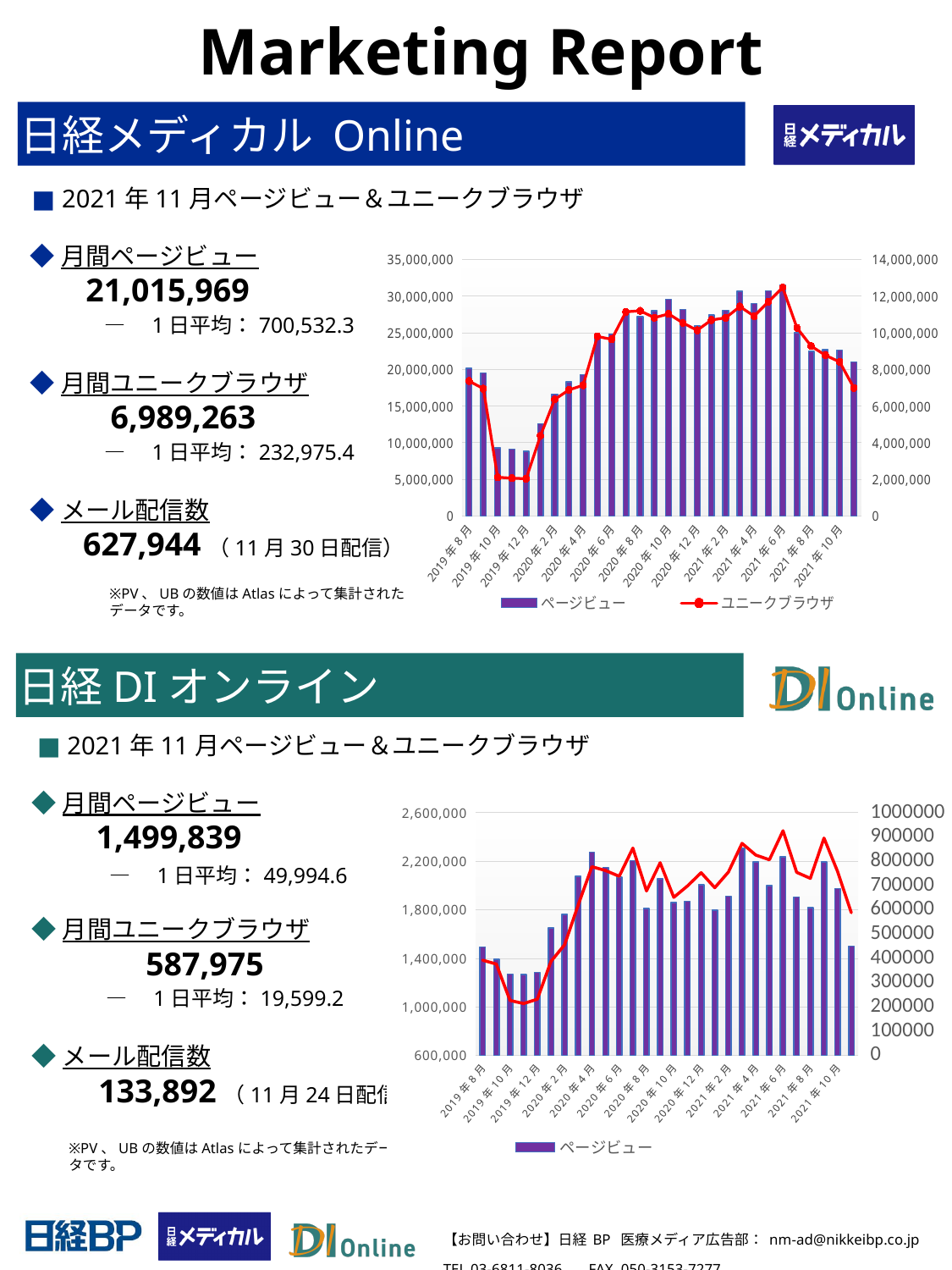
In the 日経メディカル Online chart (top), how many series does the legend list? 2 In the 日経メディカル Online chart (top), is the ユニークブラウザ value for 2020年8月 greater or less than 10,000,000 on the right axis? greater In the 日経DIオンライン chart (bottom), how many series does the legend list? 1 In the 日経メディカル Online chart (top), which month has the highest ユニークブラウザ value? 2021年6月 In the 日経メディカル Online chart (top), do the ページビュー values rise or fall from 2019年12月 to 2020年8月? rise In the 日経メディカル Online chart (top), which is larger, the ページビュー value for 2020年2月 or for 2020年4月? 2020年4月 In the 日経メディカル Online chart (top), what kind of chart is it? Combined bar and line chart In the 日経メディカル Online chart (top), which series is drawn as a red line? ユニークブラウザ In the 日経DIオンライン chart (bottom), is the ページビュー value for 2020年4月 greater or less than 2,200,000? greater In the 日経メディカル Online chart (top), is the ページビュー value for 2021年10月 greater or less than 20,000,000? greater